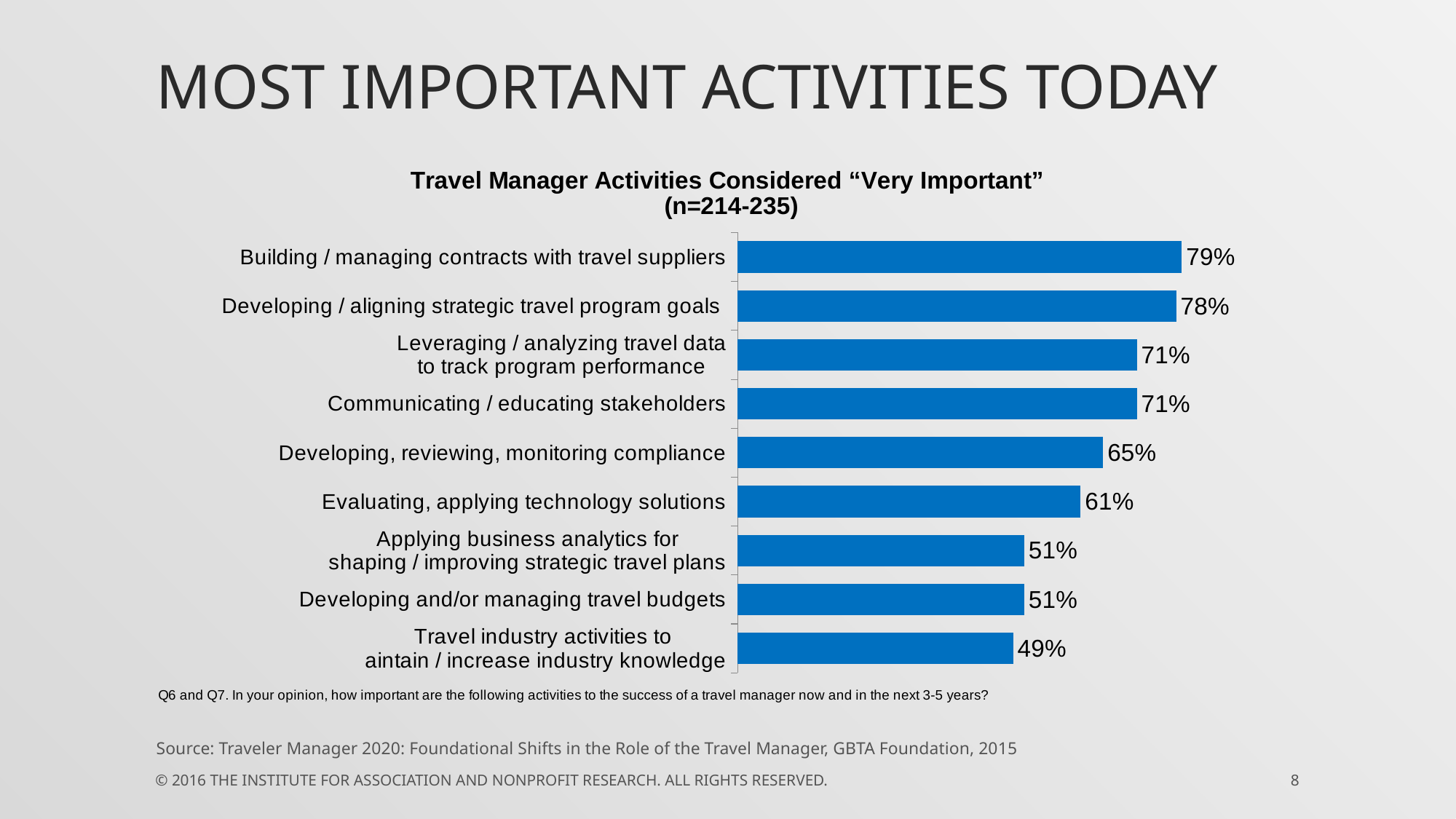
What is the value shown for "Developing / aligning strategic travel program goals"? 78% Which is larger: the value for "Communicating / educating stakeholders" or the value for "Evaluating, applying technology solutions"? Communicating / educating stakeholders What is the difference between the values for "Leveraging / analyzing travel data to track program performance" and "Applying business analytics for shaping / improving strategic travel plans"? 20 percentage points Which activity has the highest percentage considered very important? Building / managing contracts with travel suppliers What percentage of travel managers considered "Building / managing contracts with travel suppliers" very important? 79% Which activity has the lowest percentage considered very important? Travel industry activities to aintain / increase industry knowledge What is the difference between the values for "Building / managing contracts with travel suppliers" and "Developing and/or managing travel budgets"? 28 percentage points What is the value shown for "Evaluating, applying technology solutions"? 61% What is the title of the chart? Travel Manager Activities Considered "Very Important" (n=214-235) How many activities are shown in the chart? 9 What is the value shown for "Developing, reviewing, monitoring compliance"? 65% What kind of chart is shown on the slide? Bar chart